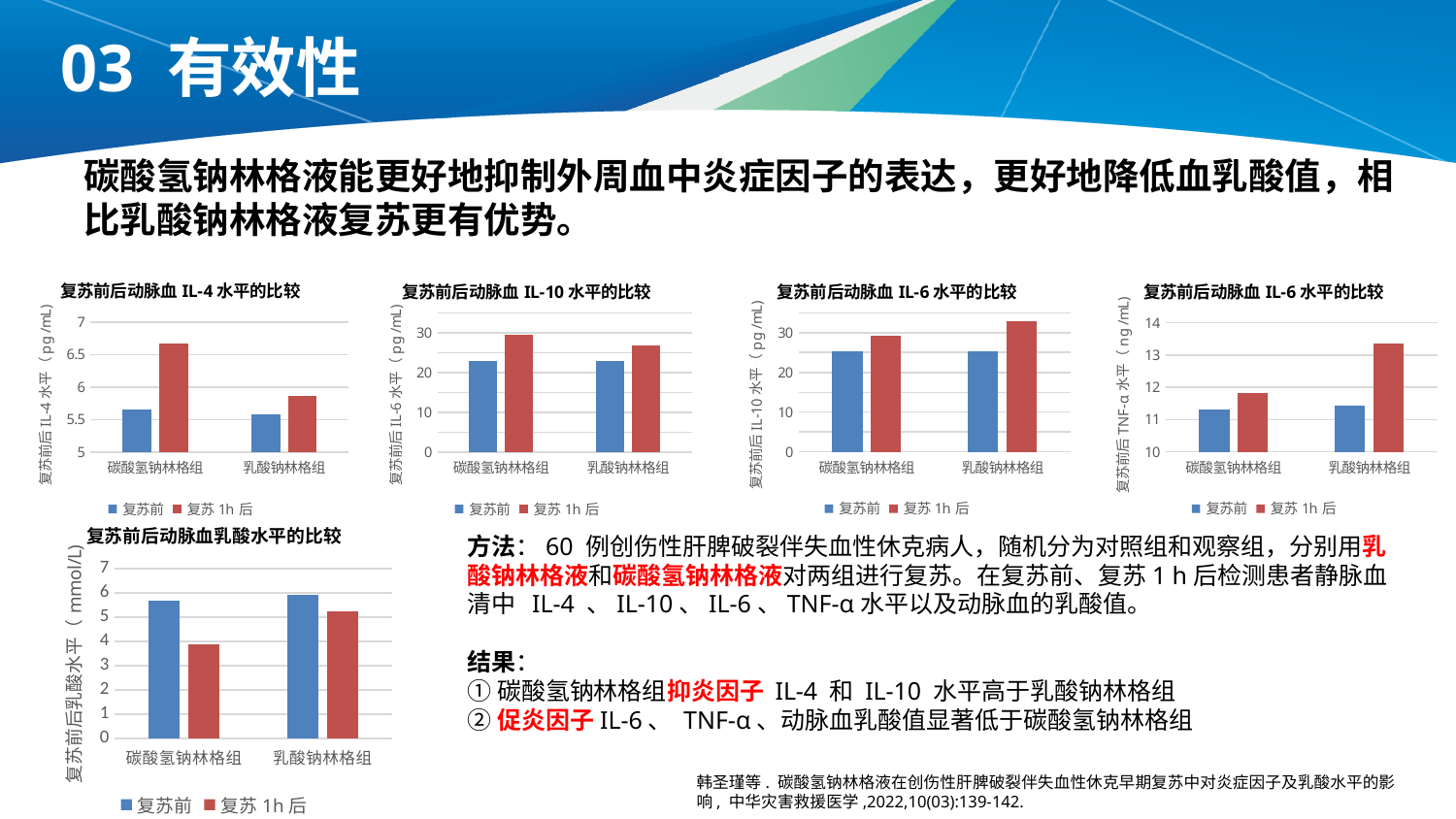
How many series does the legend of the chart titled 复苏前后动脉血乳酸水平的比较 list? 2 In the chart titled 复苏前后动脉血 IL-4 水平的比较, is the value for 碳酸氢钠林格组 复苏 1h 后 greater or less than 6.5? greater In the third chart in the top row (IL-6, pg/mL), is the value for 乳酸钠林格组 复苏 1h 后 greater or less than 30? greater In the chart titled 复苏前后动脉血乳酸水平的比较, is the value for 碳酸氢钠林格组 复苏 1h 后 greater or less than 4? less In the chart titled 复苏前后动脉血 IL-10 水平的比较, which is larger for 复苏 1h 后: 碳酸氢钠林格组 or 乳酸钠林格组? 碳酸氢钠林格组 In the chart titled 复苏前后动脉血乳酸水平的比较, which bar is the lowest? 碳酸氢钠林格组 复苏 1h 后 In the third chart in the top row (IL-6, pg/mL), which bar is the highest? 乳酸钠林格组 复苏 1h 后 In the chart titled 复苏前后动脉血 IL-4 水平的比较, which bar is the highest? 碳酸氢钠林格组 复苏 1h 后